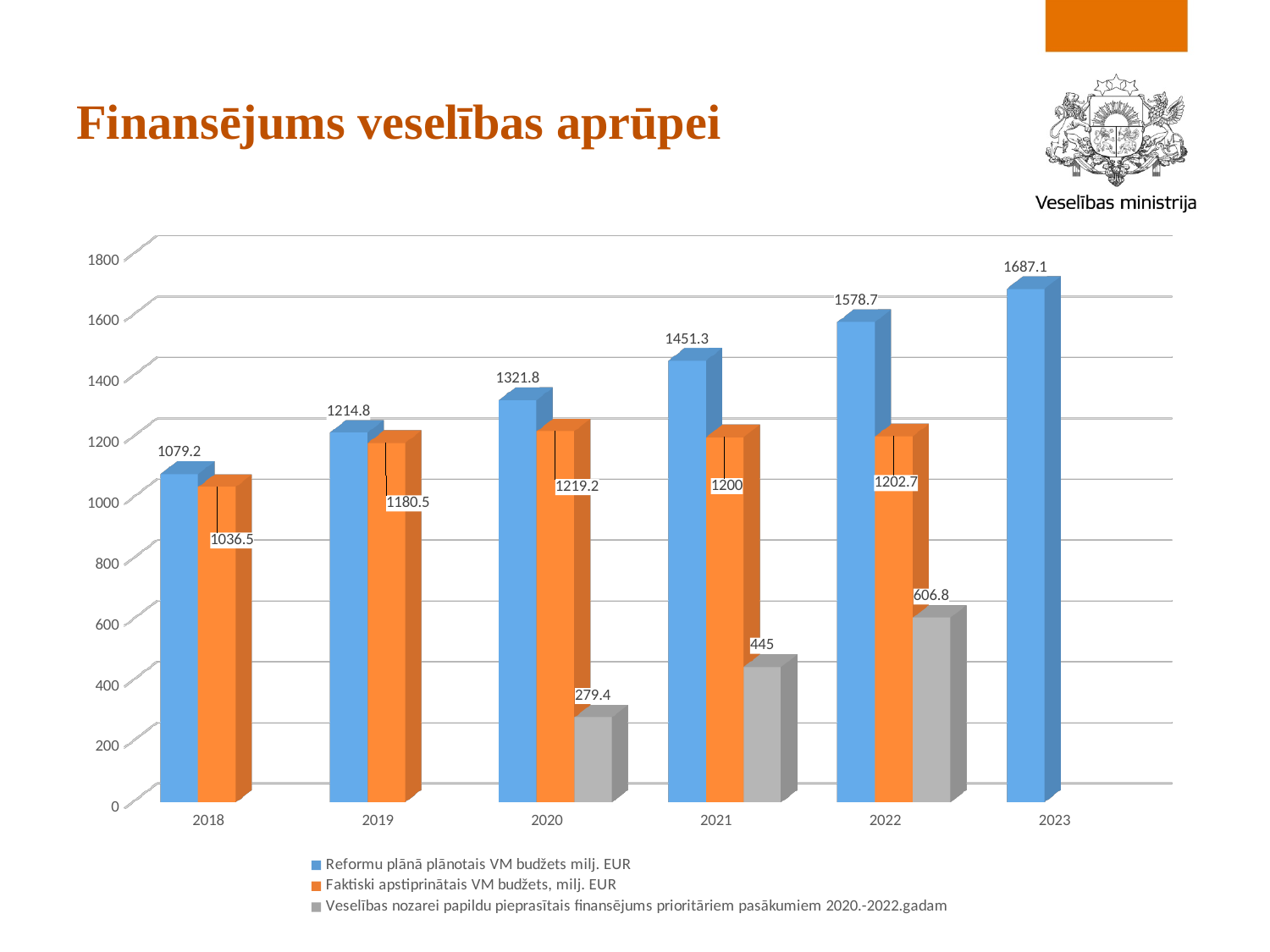
Does 'Reformu plānā plānotais VM budžets milj. EUR' rise or fall from 2018 to 2023? Rise What is the difference between 'Reformu plānā plānotais VM budžets milj. EUR' and 'Faktiski apstiprinātais VM budžets, milj. EUR' in 2022? 376 How many series does the legend list? 3 What is the value of 'Faktiski apstiprinātais VM budžets, milj. EUR' for 2019? 1180.5 What is the value of 'Veselības nozarei papildu pieprasītais finansējums prioritāriem pasākumiem 2020.-2022.gadam' for 2021? 445 What kind of chart is shown on the slide? Bar chart What is the title of the slide? Finansējums veselības aprūpei What is the value of 'Reformu plānā plānotais VM budžets milj. EUR' for 2023? 1687.1 Which year has the lowest value for 'Faktiski apstiprinātais VM budžets, milj. EUR'? 2018 Which year has the highest value for 'Reformu plānā plānotais VM budžets milj. EUR'? 2023 Which is larger in 2020: 'Reformu plānā plānotais VM budžets milj. EUR' or 'Faktiski apstiprinātais VM budžets, milj. EUR'? Reformu plānā plānotais VM budžets milj. EUR How many years are shown on the x axis? 6